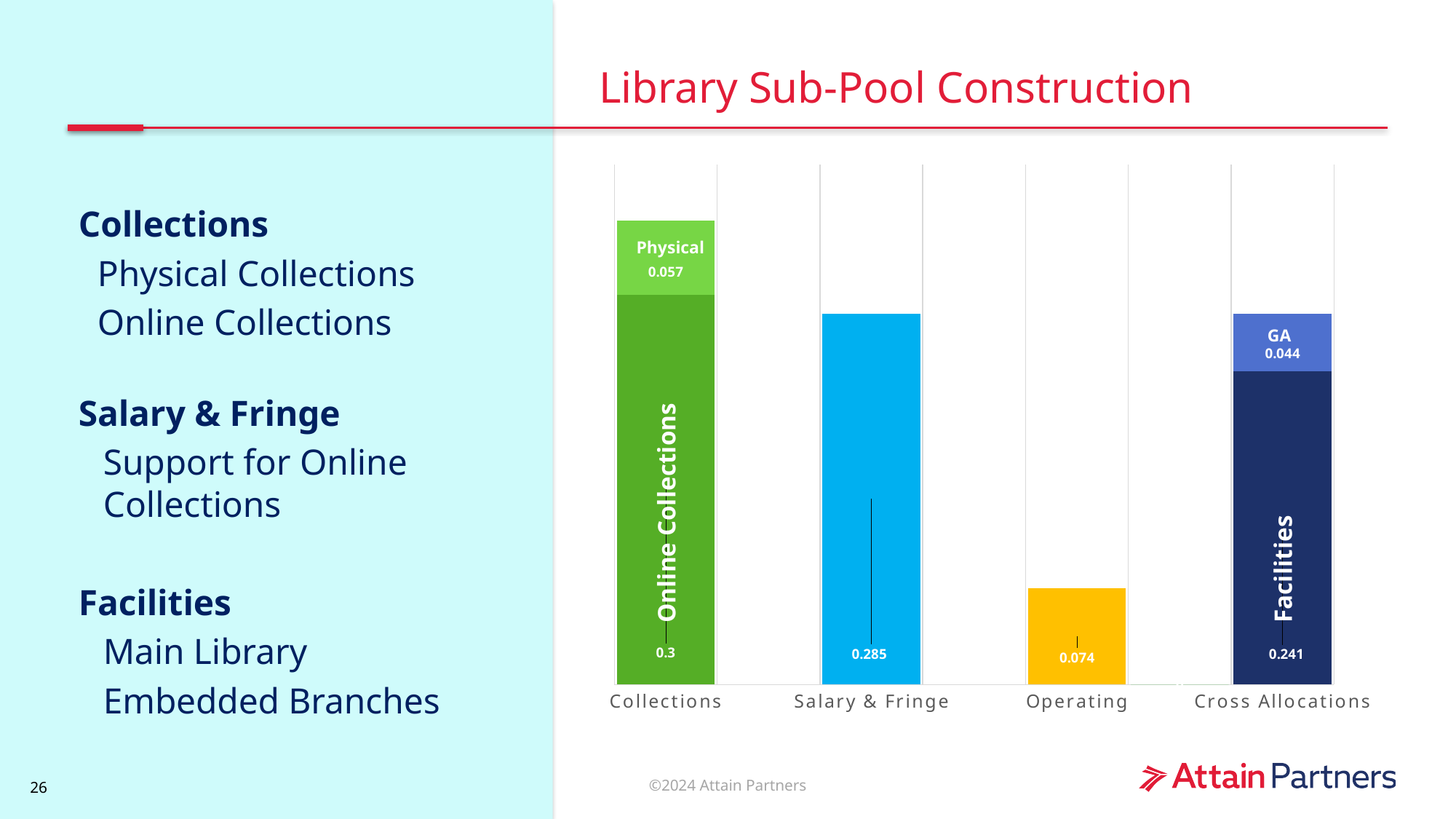
What is the total of the Cross Allocations stacked bar? 0.285 Which category has the tallest bar? Collections How many categories are shown on the x axis of the chart? 4 What is the total of the Collections stacked bar? 0.357 What is the value of the Physical segment in the Collections bar? 0.057 What is the value of the Facilities segment in the Cross Allocations bar? 0.241 What is the value of the Online Collections segment in the Collections bar? 0.3 What is the difference between the Salary & Fringe value and the Operating value? 0.211 What is the value of the GA segment in the Cross Allocations bar? 0.044 What is the value shown for Operating? 0.074 What is the value shown for Salary & Fringe? 0.285 Which category has the lowest bar? Operating